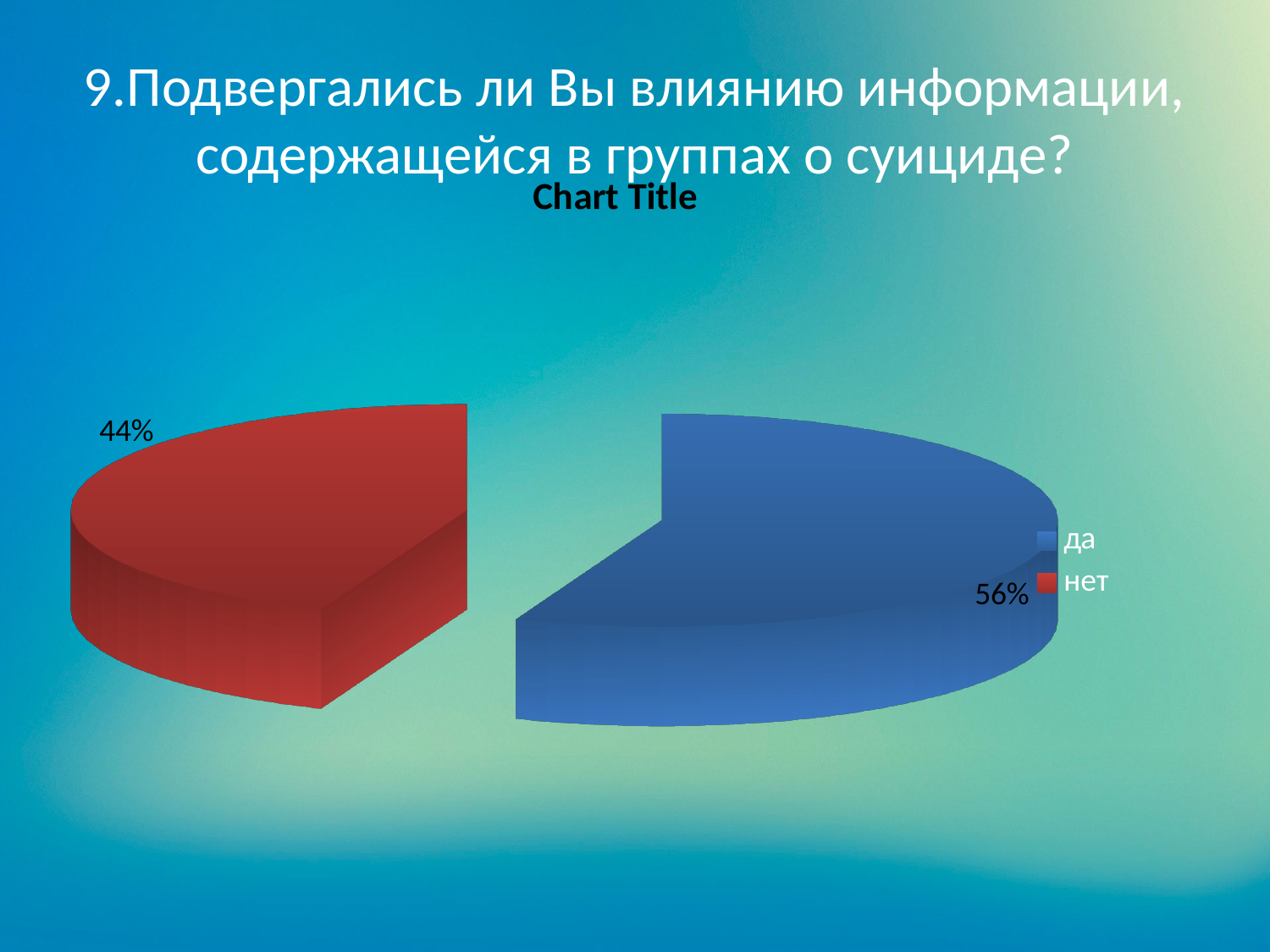
Which is larger, the "да" slice or the "нет" slice? да Which slice of the pie is the largest? да What is the difference in percentage points between the "да" and "нет" slices? 12 What percentage of the pie is labelled "да"? 56% What kind of chart is shown on the slide? pie chart Which slice of the pie is the smallest? нет What percentage of the pie is labelled "нет"? 44% What colour is the "нет" slice? red How many entries does the legend list? 2 What is the title shown above the pie chart? Chart Title How many slices does the pie chart have? 2